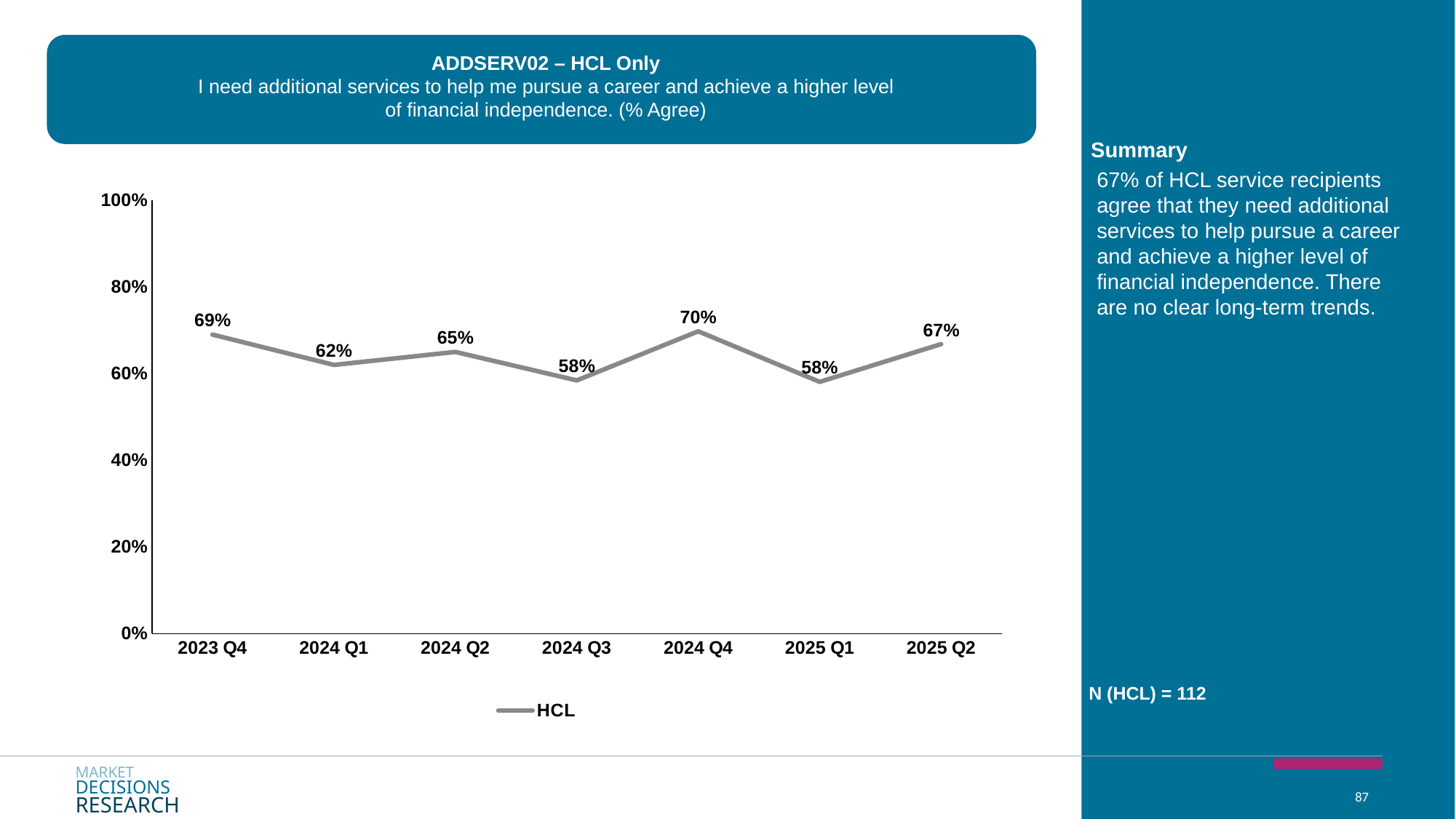
How many series does the legend list? 1 What is the value for 2024 Q4? 70% What series name appears in the legend? HCL Which quarter has the highest value? 2024 Q4 How many quarters are plotted on the x axis? 7 Is the value for 2024 Q3 greater or less than 60%? less What is the lowest value shown on the chart? 58% What is the difference between the values for 2024 Q4 and 2025 Q1? 12% What is the value for 2025 Q2? 67% Which is larger, the value for 2024 Q1 or the value for 2024 Q2? 2024 Q2 What kind of chart is shown? line chart What is the value for 2023 Q4? 69%